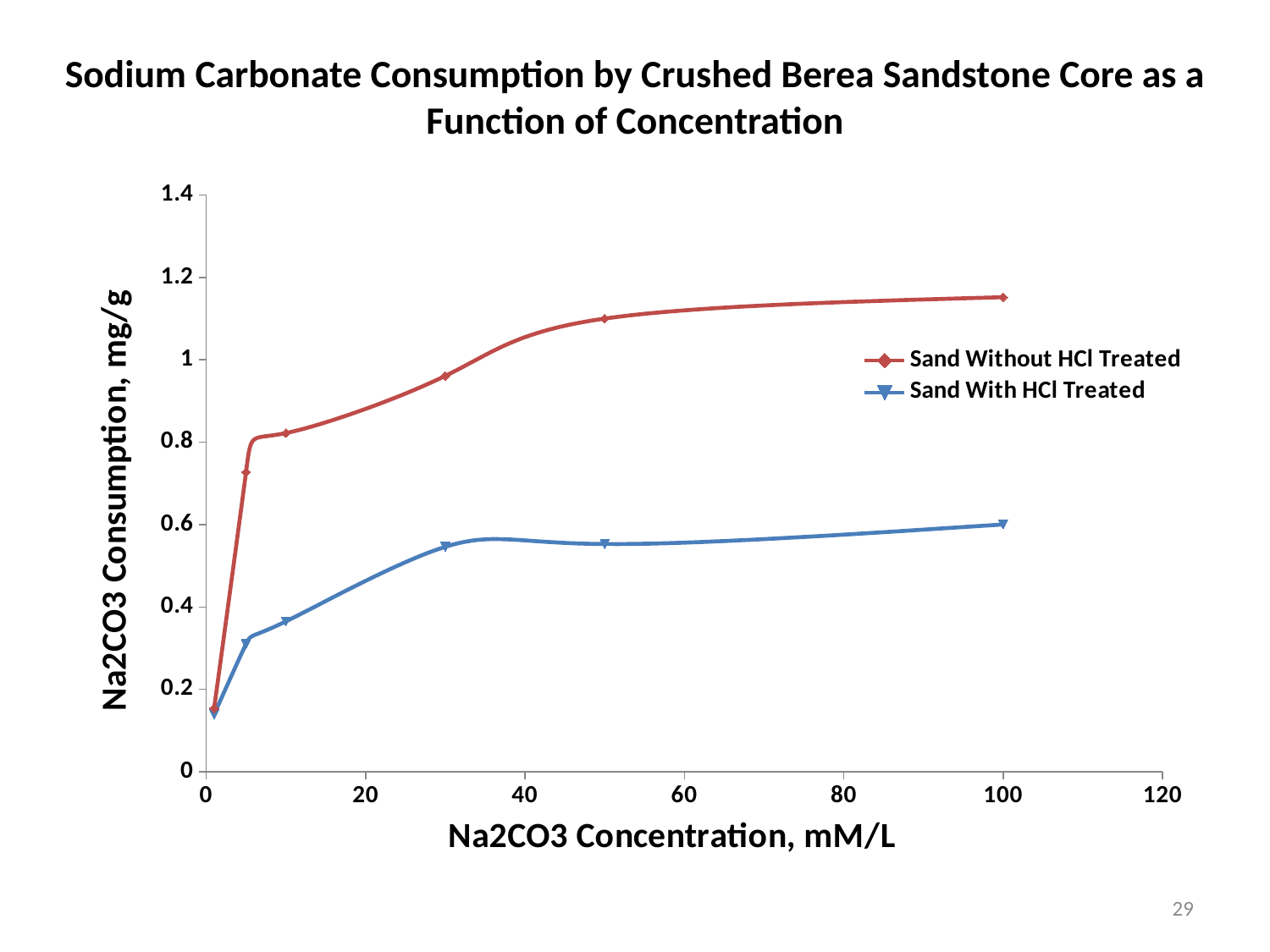
Is the value for Sand Without HCl Treated at 50 mM/L greater or less than 1? greater Is the value for Sand With HCl Treated at 5 mM/L greater or less than 0.4? less How many series does the legend list? 2 What colour is the line for the Sand With HCl Treated series? blue What kind of chart is shown on the slide? line chart How many data points are plotted for the Sand Without HCl Treated series? 6 Does the Na2CO3 consumption for Sand Without HCl Treated generally rise or fall as concentration increases? rise What is the label of the y axis? Na2CO3 Consumption, mg/g Is the value for Sand Without HCl Treated at 100 mM/L greater or less than 1? greater Which series has the higher Na2CO3 consumption at 100 mM/L, Sand Without HCl Treated or Sand With HCl Treated? Sand Without HCl Treated